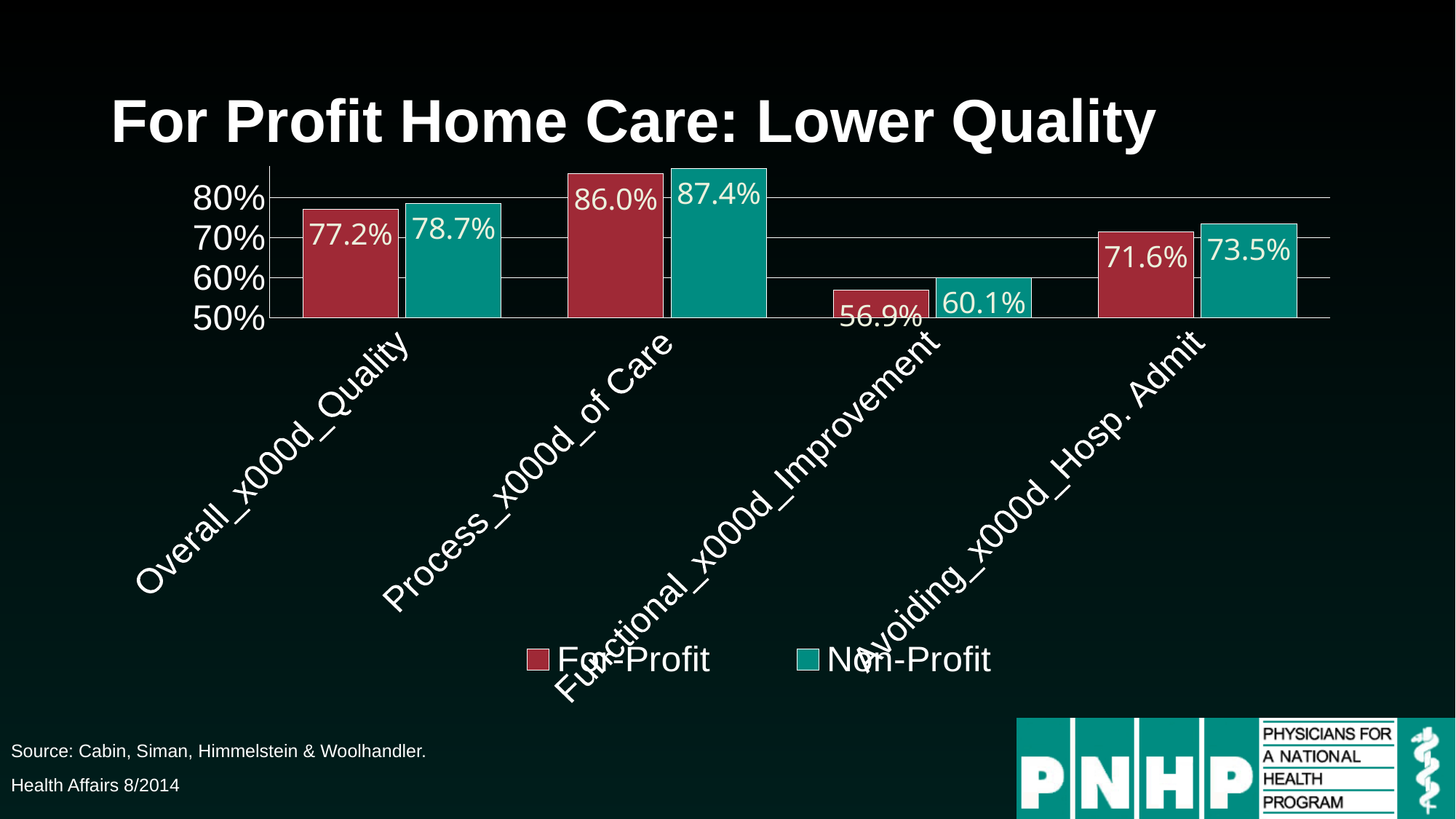
What type of chart is shown on the slide? Bar chart What is the Non-Profit value for Functional Improvement? 60.1% What is the Non-Profit value for Process of Care? 87.4% What is the For-Profit value for Overall Quality? 77.2% Which category has the highest Non-Profit value? Process of Care How many categories are shown on the x axis? 4 For Avoiding Hosp. Admit, which series has the larger value, For-Profit or Non-Profit? Non-Profit What is the For-Profit value for Avoiding Hosp. Admit? 71.6% What is the difference between the Non-Profit and For-Profit values for Process of Care? 1.4% Which category has the lowest For-Profit value? Functional Improvement How many series does the legend list? 2 What is the difference between the Non-Profit and For-Profit values for Functional Improvement? 3.2%